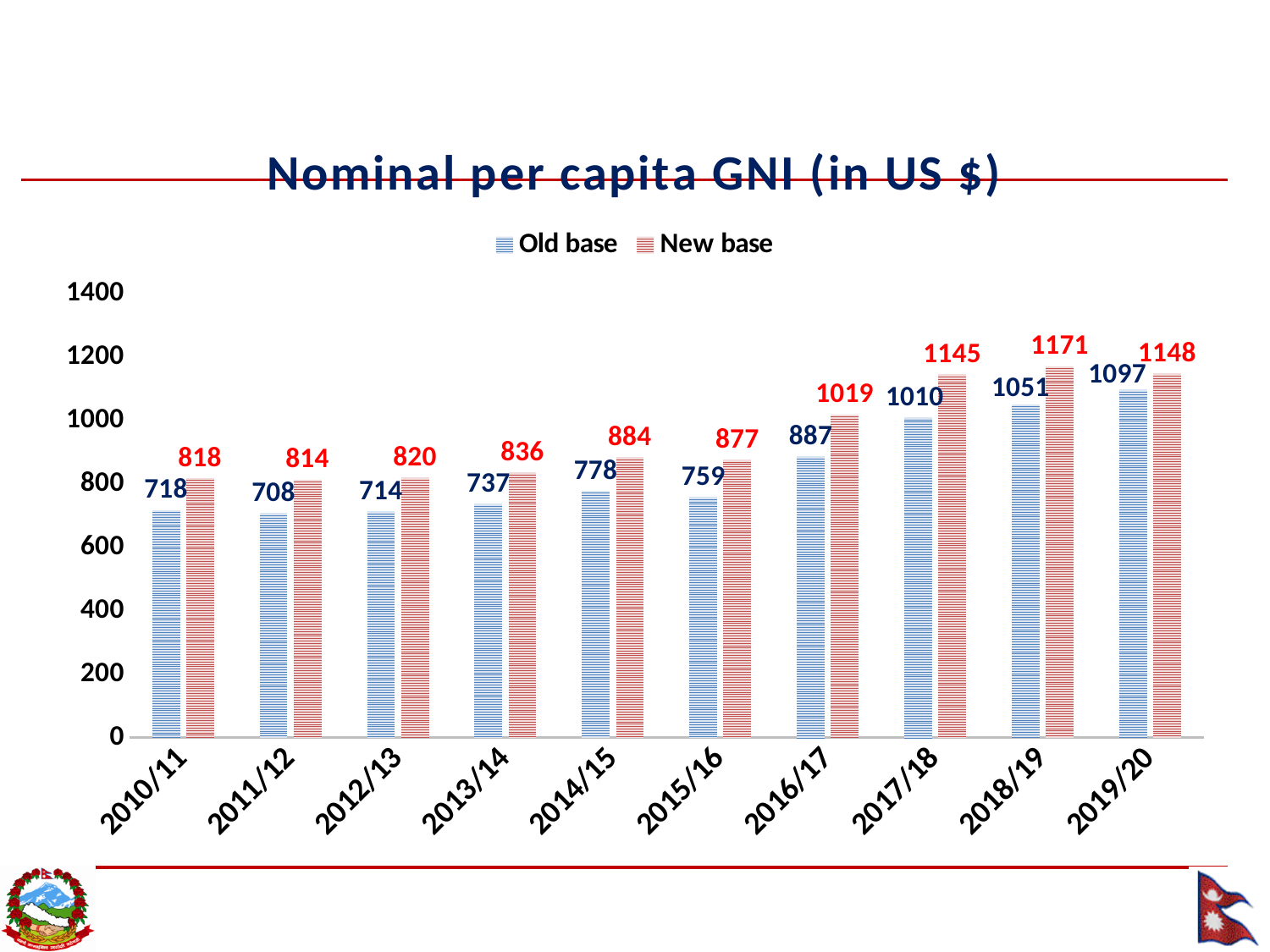
How many series does the legend list? 2 Which is larger, the Old base value for 2016/17 or the New base value for 2015/16? Old base value for 2016/17 Is the Old base value for 2017/18 greater or less than 1000? greater What is the New base value for 2014/15? 884 How many fiscal years are shown on the x axis? 10 What is the New base value for 2017/18? 1145 What is the Old base value for 2010/11? 718 What is the difference between the New base and Old base values for 2019/20? 51 Which year has the lowest Old base value? 2011/12 What is the title of the chart? Nominal per capita GNI (in US $) Which year has the highest New base value? 2018/19 What kind of chart is shown on the slide? Bar chart